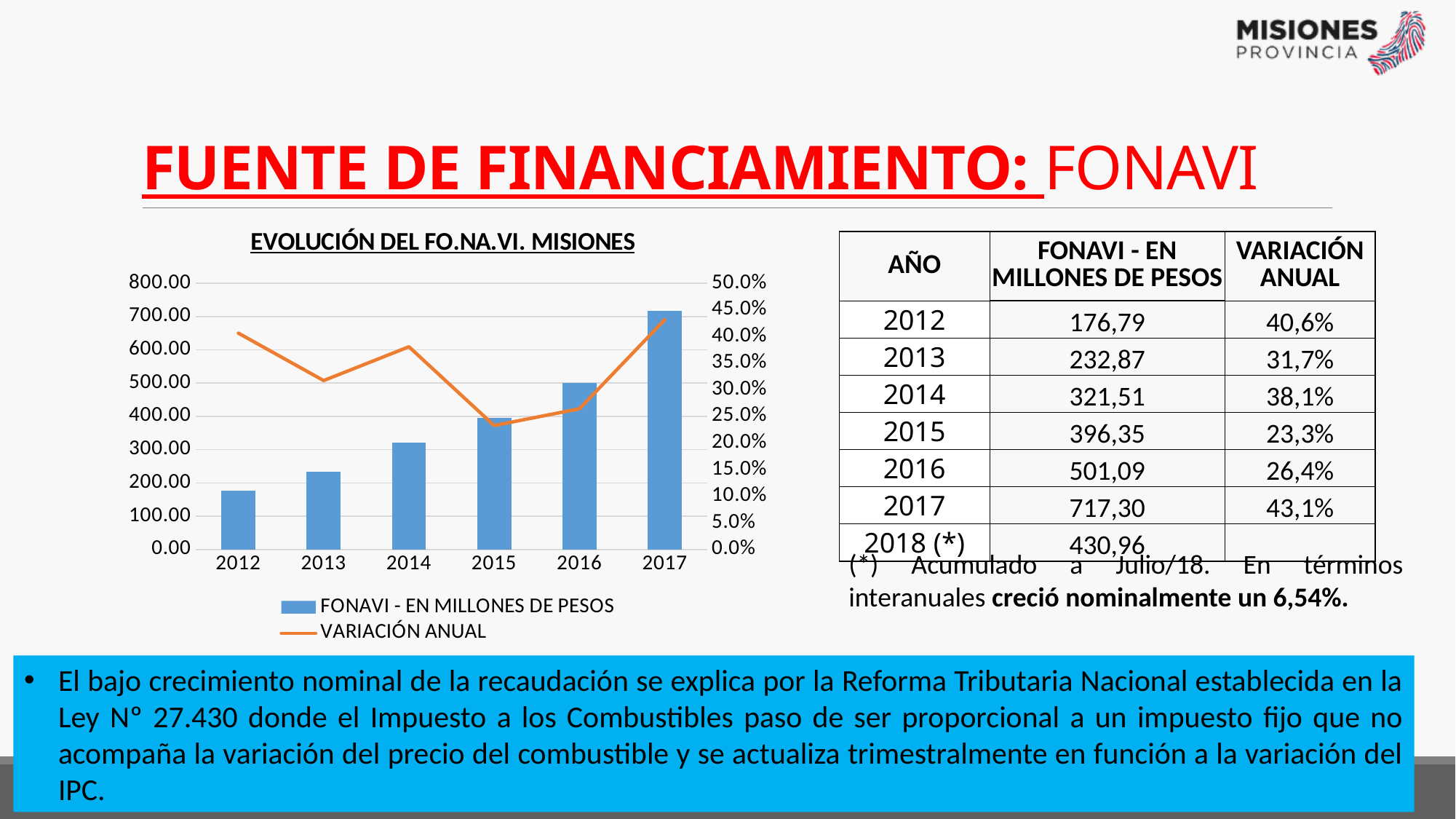
Is the VARIACIÓN ANUAL value for 2014 greater or less than 35.0%? greater How many series does the legend of the chart list? 2 In which year does the VARIACIÓN ANUAL line reach its lowest point? 2015 Is the FONAVI bar for 2014 greater or less than 300.00? greater Is the FONAVI bar for 2017 greater or less than 700.00? greater How many years are plotted on the x axis of the chart? 6 Which year has the shortest bar for FONAVI - EN MILLONES DE PESOS? 2012 Which year has the tallest bar for FONAVI - EN MILLONES DE PESOS? 2017 Which is larger, the FONAVI bar for 2016 or the FONAVI bar for 2015? 2016 What colour is the VARIACIÓN ANUAL line in the chart? Orange What kind of chart is shown under the title 'EVOLUCIÓN DEL FO.NA.VI. MISIONES'? A bar chart combined with a line chart Do the FONAVI - EN MILLONES DE PESOS bars rise or fall from 2012 to 2017? Rise